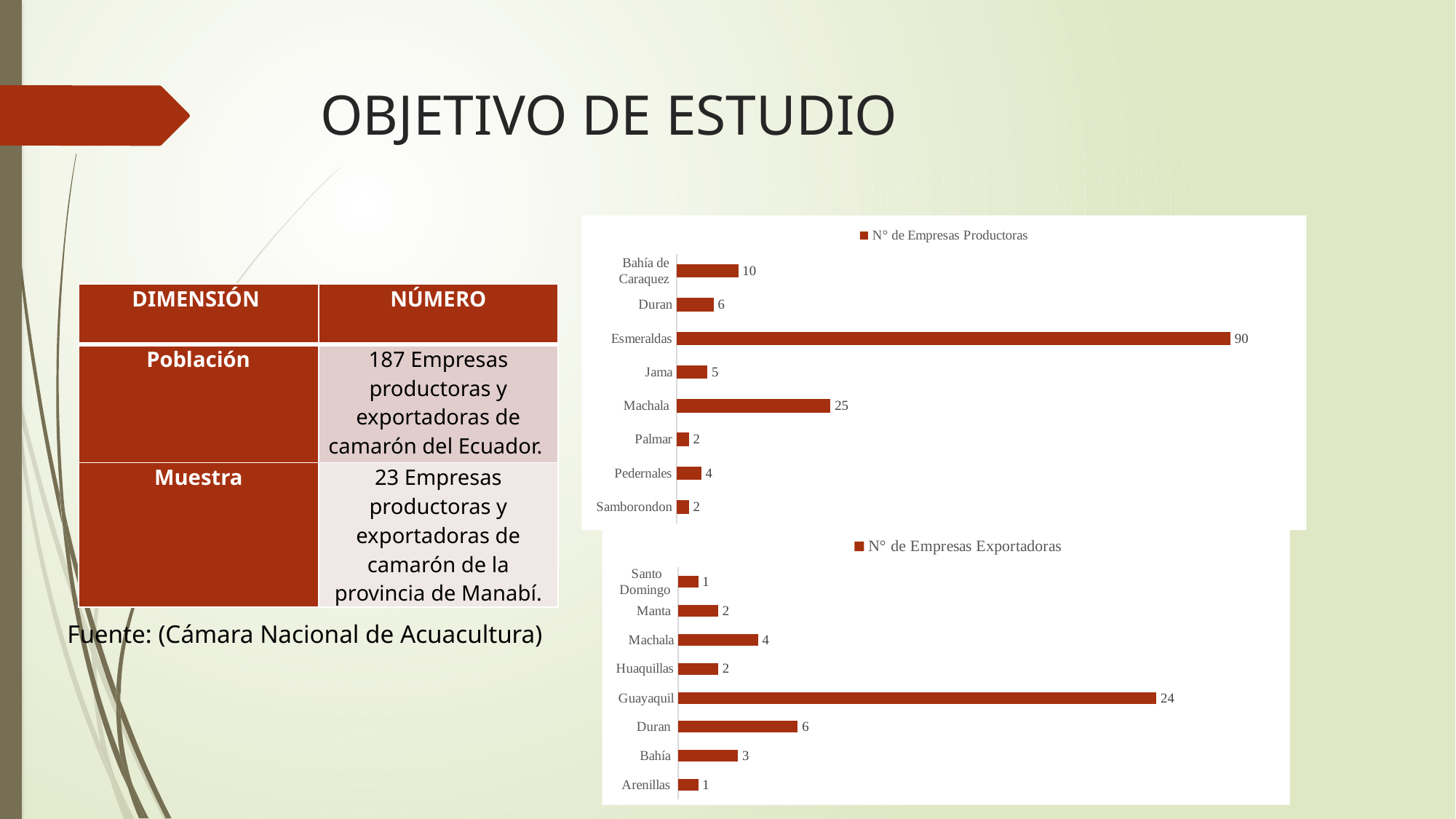
In the 'N° de Empresas Productoras' chart, what is the difference between Esmeraldas and Machala? 65 In the 'N° de Empresas Exportadoras' chart, how many categories are shown? 8 In the 'N° de Empresas Productoras' chart, what is the value for Machala? 25 In the 'N° de Empresas Exportadoras' chart, what is the difference between Guayaquil and Duran? 18 In the 'N° de Empresas Exportadoras' chart, what is the value for Duran? 6 In the 'N° de Empresas Exportadoras' chart, which category has the highest value? Guayaquil In the 'N° de Empresas Productoras' chart, what is the value for Esmeraldas? 90 What type of chart is the 'N° de Empresas Exportadoras' chart? Bar chart In the 'N° de Empresas Productoras' chart, which is larger, Bahía de Caraquez or Duran? Bahía de Caraquez In the 'N° de Empresas Exportadoras' chart, what is the value for Guayaquil? 24 In the 'N° de Empresas Productoras' chart, which category has the highest value? Esmeraldas In the 'N° de Empresas Productoras' chart, how many categories are shown? 8